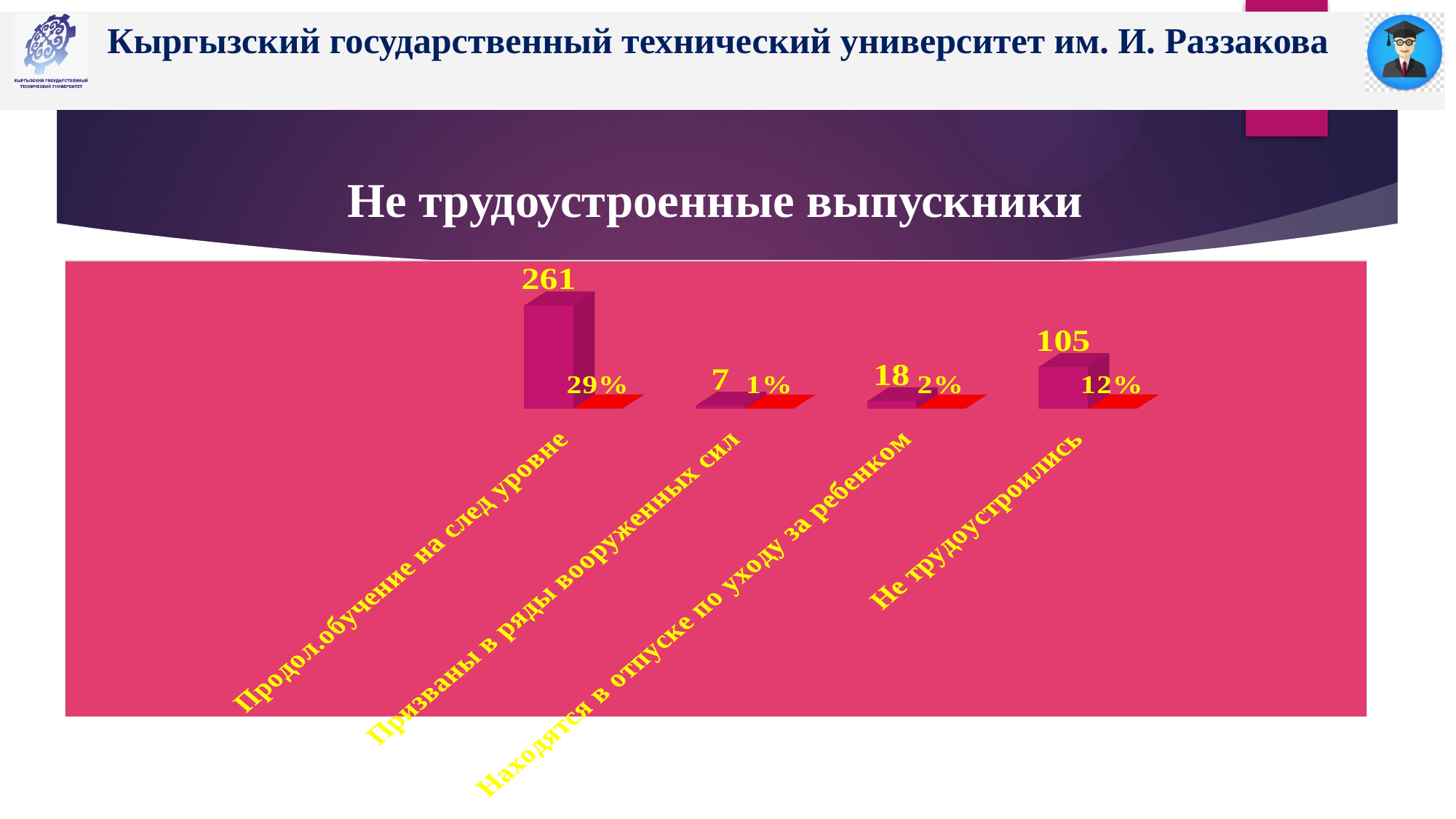
What is the difference between the number of graduates for "Продол.обучение на след уровне" and "Не трудоустроились"? 156 What is the title of the chart on the slide? Не трудоустроенные выпускники What percentage is shown for "Продол.обучение на след уровне"? 29% How many categories are shown on the chart? 4 Which category has the highest number of graduates? Продол.обучение на след уровне Which category has the lowest number of graduates? Призваны в ряды вооруженных сил Which is larger: the number for "Находятся в отпуске по уходу за ребенком" or for "Призваны в ряды вооруженных сил"? Находятся в отпуске по уходу за ребенком What is the number of graduates for "Призваны в ряды вооруженных сил"? 7 What percentage is shown for "Находятся в отпуске по уходу за ребенком"? 2% What is the number of graduates for "Не трудоустроились"? 105 What is the number of graduates for "Продол.обучение на след уровне"? 261 What kind of chart is shown on the slide? Bar chart